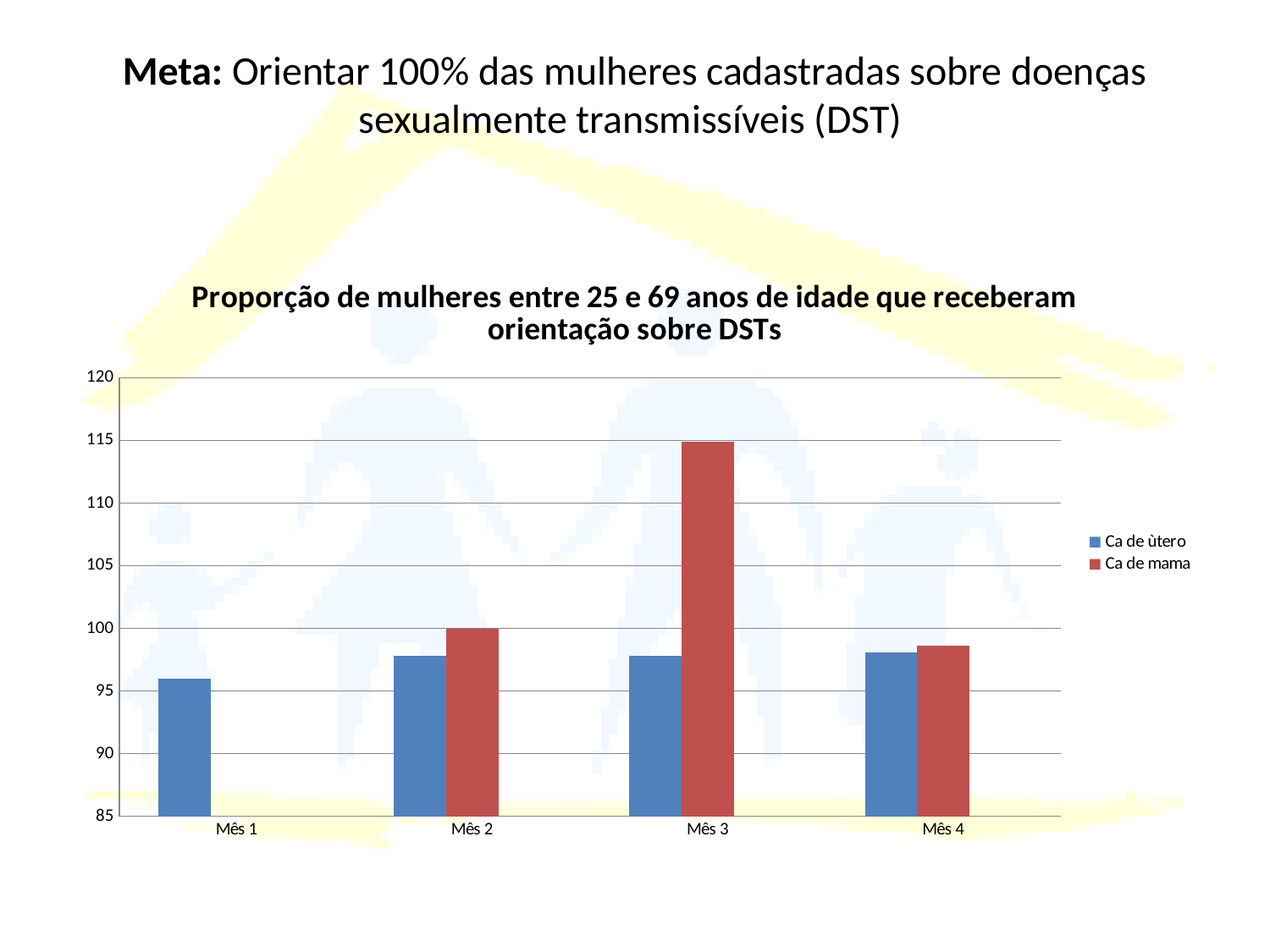
In which month is the value for Ca de mama highest? Mês 3 Is the value for Ca de mama in Mês 3 greater or less than 110? greater What is the title of the chart? Proporção de mulheres entre 25 e 69 anos de idade que receberam orientação sobre DSTs Is the value for Ca de mama in Mês 4 greater or less than 100? less In Mês 3, which series has the larger value, Ca de ùtero or Ca de mama? Ca de mama How many series does the legend list? 2 Which series is shown in red in the legend? Ca de mama Is the value for Ca de ùtero in Mês 1 greater or less than 95? greater What kind of chart is shown on the slide? bar chart How many month categories are shown on the x axis? 4 In which month is the value for Ca de ùtero lowest? Mês 1